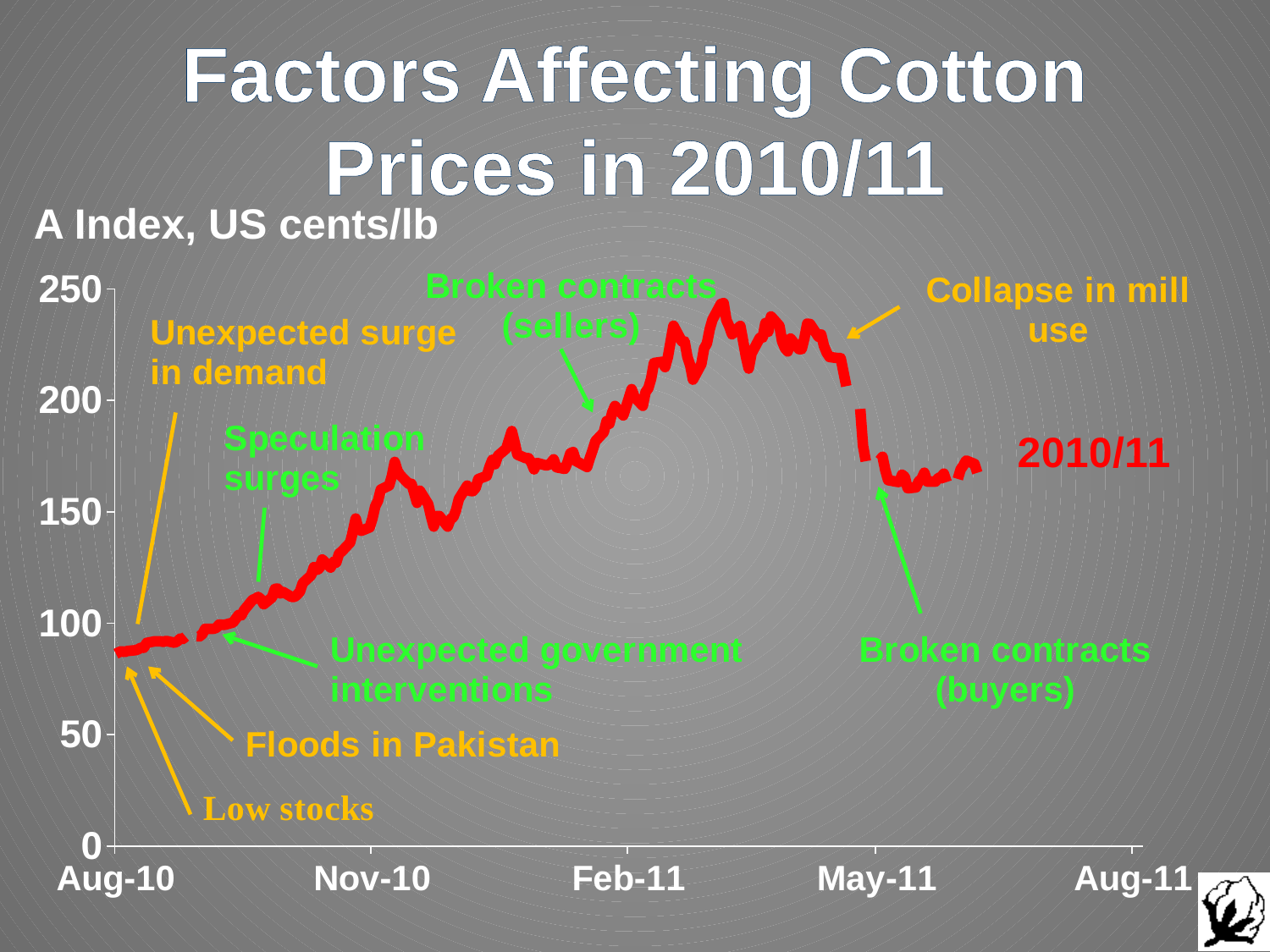
Is the value of the A Index at Feb-11 greater or less than 150? greater Is the value of the A Index at the end of the plotted line greater or less than 150? greater What unit is the A Index plotted in, according to the label above the chart? US cents/lb Does the A Index rise or fall between its peak in early 2011 and the end of the plotted line? fall Which is larger, the A Index at Aug-10 or the A Index at Feb-11? Feb-11 What kind of chart is shown on the slide? line chart Is the value of the A Index at Nov-10 greater or less than 100? greater What is the title of the chart on the slide? Factors Affecting Cotton Prices in 2010/11 Does the A Index rise or fall between Aug-10 and Feb-11? rise How many data series are plotted on the chart? 1